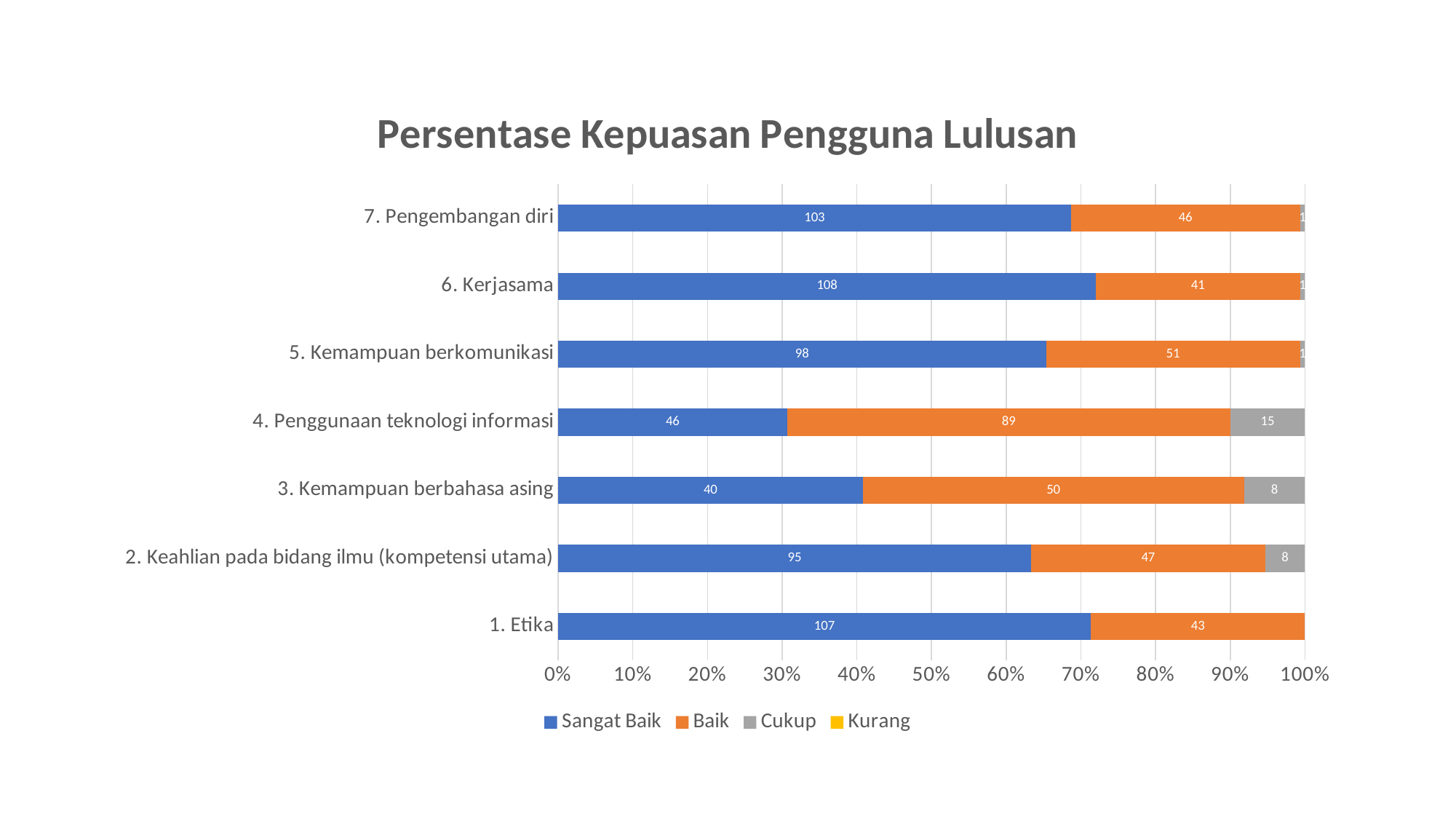
What is the title of the chart? Persentase Kepuasan Pengguna Lulusan How many categories are shown on the chart? 7 Which category has the highest Sangat Baik value? 6. Kerjasama What is the total of the stacked bar for 3. Kemampuan berbahasa asing? 98 What is the Baik value for 4. Penggunaan teknologi informasi? 89 What is the Sangat Baik value for 6. Kerjasama? 108 What is the Cukup value for 3. Kemampuan berbahasa asing? 8 What is the difference between the Sangat Baik values for 1. Etika and 2. Keahlian pada bidang ilmu (kompetensi utama)? 12 Which is larger, the Baik value for 5. Kemampuan berkomunikasi or the Baik value for 7. Pengembangan diri? 5. Kemampuan berkomunikasi How many series does the legend list? 4 Which category has the lowest Sangat Baik value? 3. Kemampuan berbahasa asing What type of chart is shown on the slide? Stacked bar chart